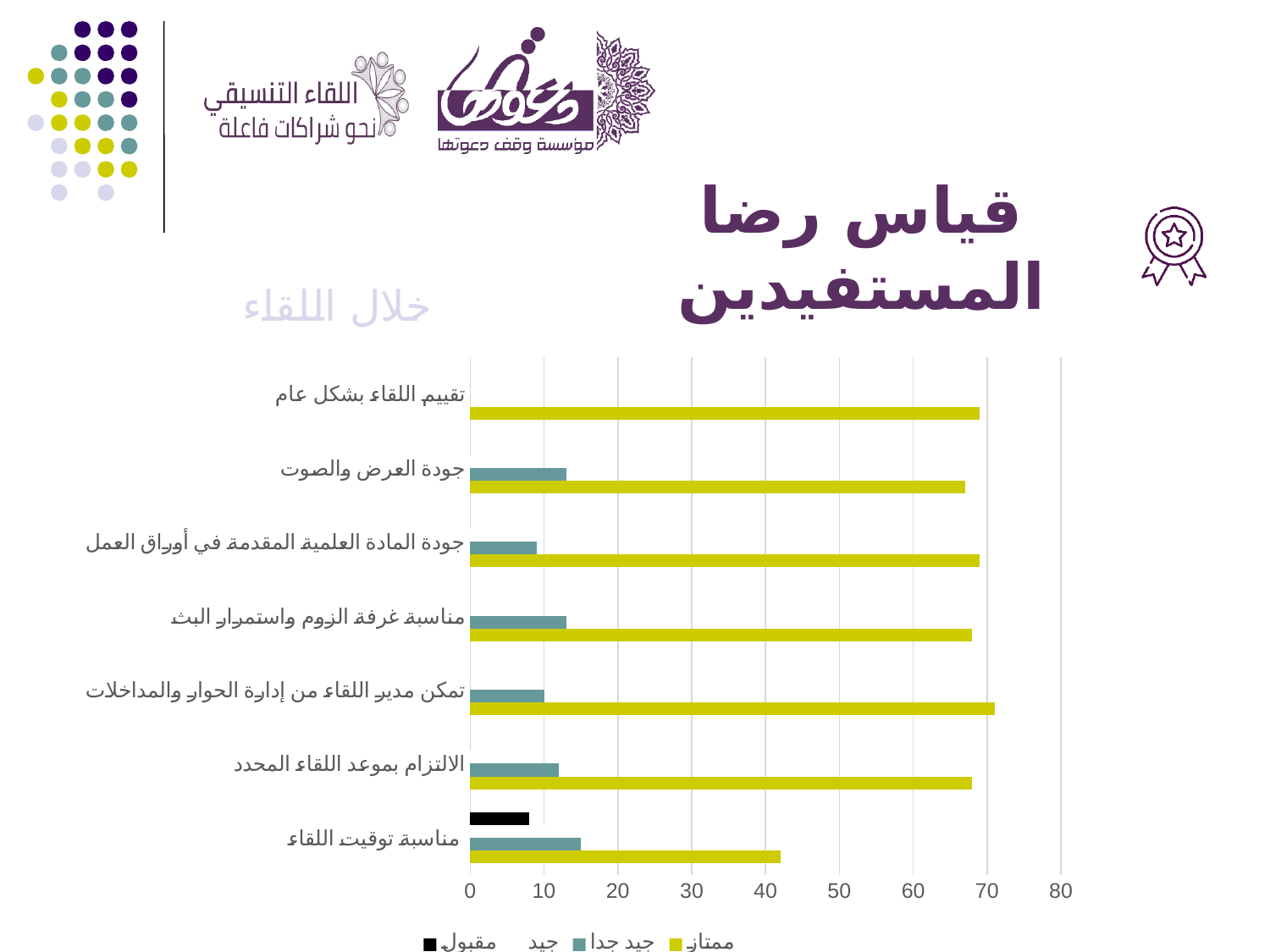
Which category has the lowest value for the ممتاز series? مناسبة توقيت اللقاء Is the ممتاز value for مناسبة توقيت اللقاء greater or less than 50? less Which is larger: the ممتاز value for تقييم اللقاء بشكل عام or the ممتاز value for مناسبة توقيت اللقاء? تقييم اللقاء بشكل عام How many series does the legend list? 4 How many categories are plotted on the chart? 7 Is the جيد جدا value for جودة العرض والصوت greater or less than 20? less What is the title of the chart? خلال اللقاء Is the ممتاز value for تمكن مدير اللقاء من إدارة الحوار والمداخلات greater or less than 60? greater Which is larger: the جيد جدا value for مناسبة توقيت اللقاء or the جيد جدا value for جودة المادة العلمية المقدمة في أوراق العمل? مناسبة توقيت اللقاء Which category is the only one with a visible مقبول bar? مناسبة توقيت اللقاء What kind of chart is shown on the slide? bar chart